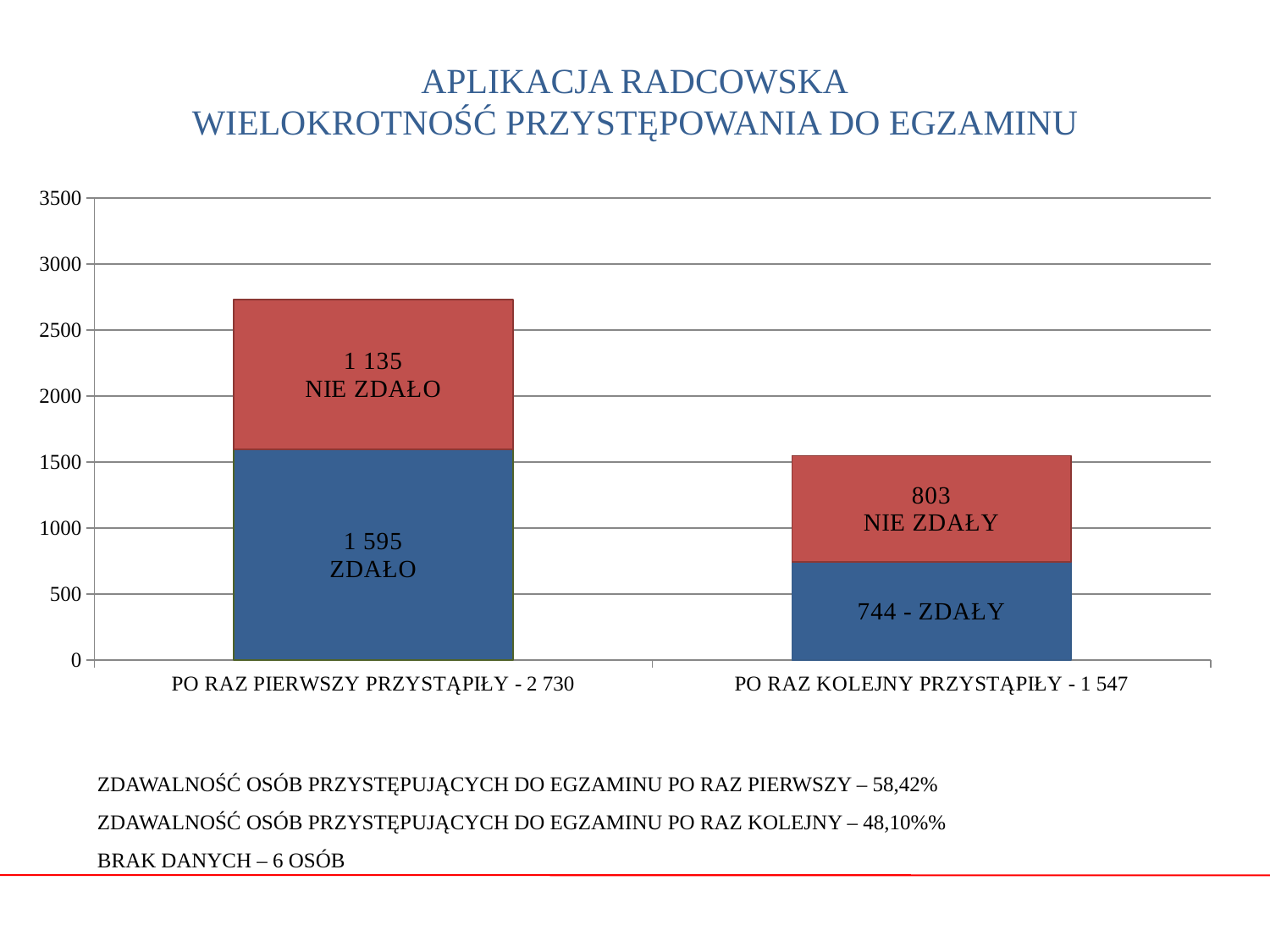
What is the total of the stacked bar for PO RAZ PIERWSZY PRZYSTĄPIŁY? 2 730 How many categories are shown on the x axis of the chart? 2 How many people did not pass (NIE ZDAŁO) among those who took the exam for the first time? 1 135 How many people did not pass (NIE ZDAŁY) among those who took the exam again? 803 How many people passed (ZDAŁO) among those who took the exam for the first time (PO RAZ PIERWSZY PRZYSTĄPIŁY)? 1 595 Which category has the taller stacked bar, PO RAZ PIERWSZY PRZYSTĄPIŁY or PO RAZ KOLEJNY PRZYSTĄPIŁY? PO RAZ PIERWSZY PRZYSTĄPIŁY How many people passed (ZDAŁY) among those who took the exam again (PO RAZ KOLEJNY PRZYSTĄPIŁY)? 744 What is the total of the stacked bar for PO RAZ KOLEJNY PRZYSTĄPIŁY? 1 547 Is the total for PO RAZ KOLEJNY PRZYSTĄPIŁY greater or less than 2000? less What is the difference between the number who passed and the number who did not pass among first-time takers? 460 What kind of chart is shown on the slide? stacked bar chart What is the title of the chart? APLIKACJA RADCOWSKA WIELOKROTNOŚĆ PRZYSTĘPOWANIA DO EGZAMINU